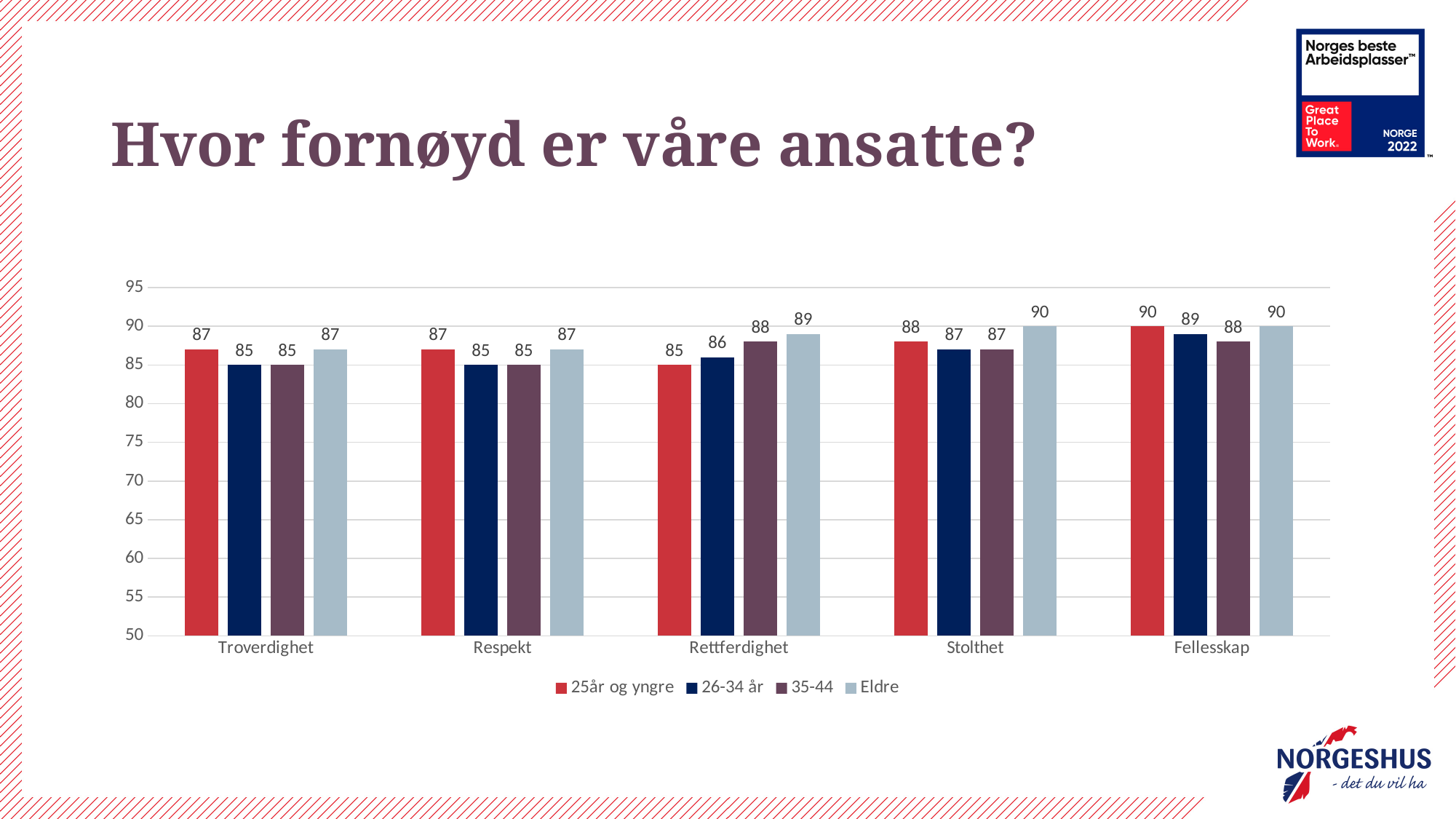
In the Rettferdighet category, which is larger: the value for '25år og yngre' or the value for 'Eldre'? Eldre How many categories are shown on the x axis? 5 What is the value for '35-44' in the Stolthet category? 87 What is the value for '26-34 år' in the Fellesskap category? 89 Which category has the highest value for the '35-44' series? Rettferdighet and Fellesskap (both 88) What is the value for '25år og yngre' in the Troverdighet category? 87 What kind of chart is shown on the slide? Bar chart Which category has the lowest value for the '25år og yngre' series? Rettferdighet What is the value for 'Eldre' in the Rettferdighet category? 89 What is the difference between the 'Eldre' and '26-34 år' values in the Stolthet category? 3 What is the title of the slide? Hvor fornøyd er våre ansatte? How many series does the legend list? 4